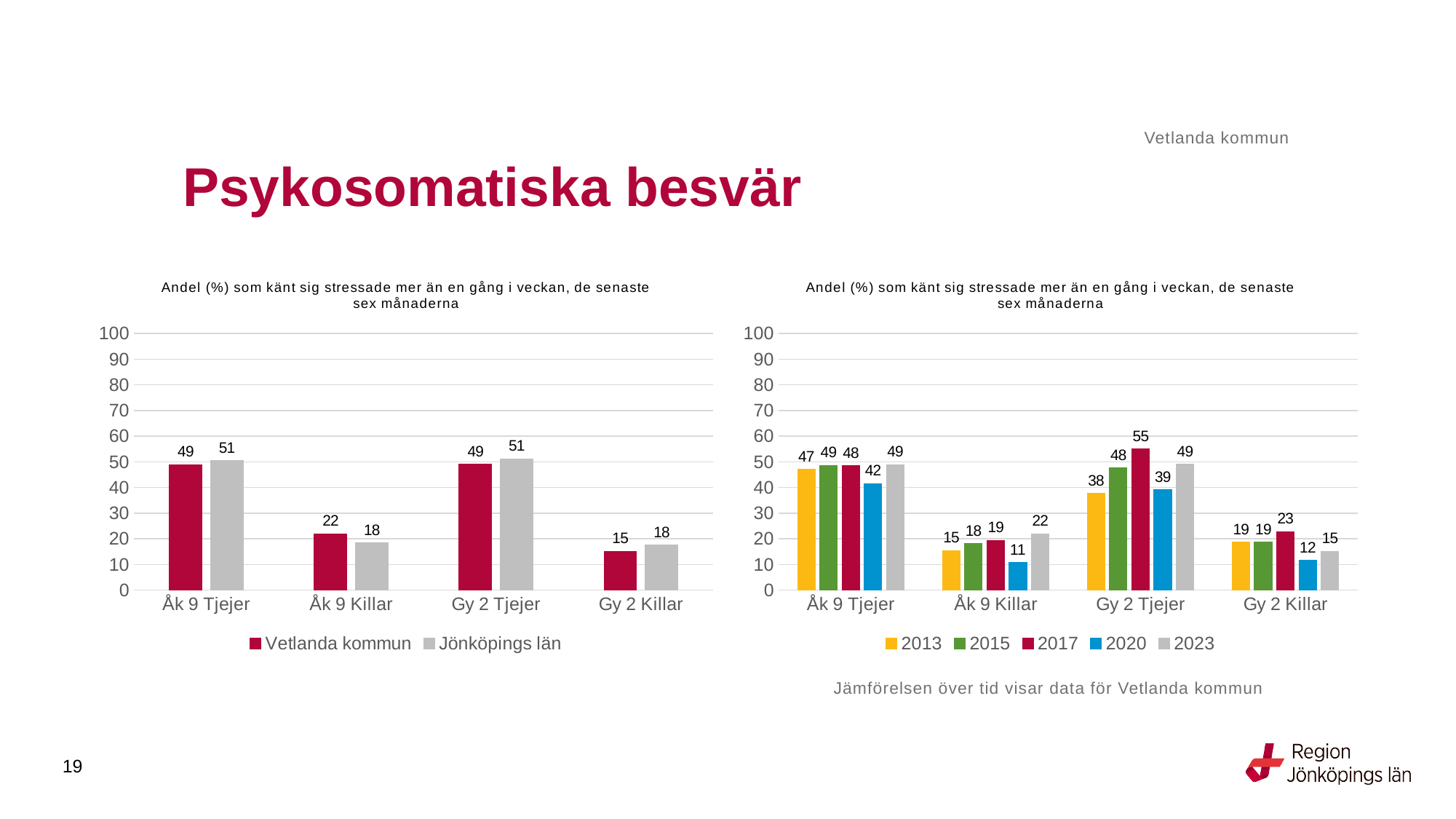
In the left chart, what is the difference between Vetlanda kommun and Jönköpings län for Åk 9 Killar? 4 In the right chart, what is the value for 2020 for Åk 9 Killar? 11 In the left chart, how many series does the legend list? 2 In the left chart, which category has the lowest value for Vetlanda kommun? Gy 2 Killar What kind of chart is the right chart? Bar chart In the right chart, what is the value for 2017 for Gy 2 Tjejer? 55 In the left chart, what is the value for Vetlanda kommun for Åk 9 Killar? 22 In the right chart, how many series does the legend list? 5 In the right chart, which is larger for Gy 2 Killar: 2013 or 2023? 2013 In the right chart, which year has the highest value for Gy 2 Tjejer? 2017 In the left chart, what is the value for Jönköpings län for Gy 2 Killar? 18 In the right chart, what is the difference between 2017 and 2013 for Gy 2 Tjejer? 17